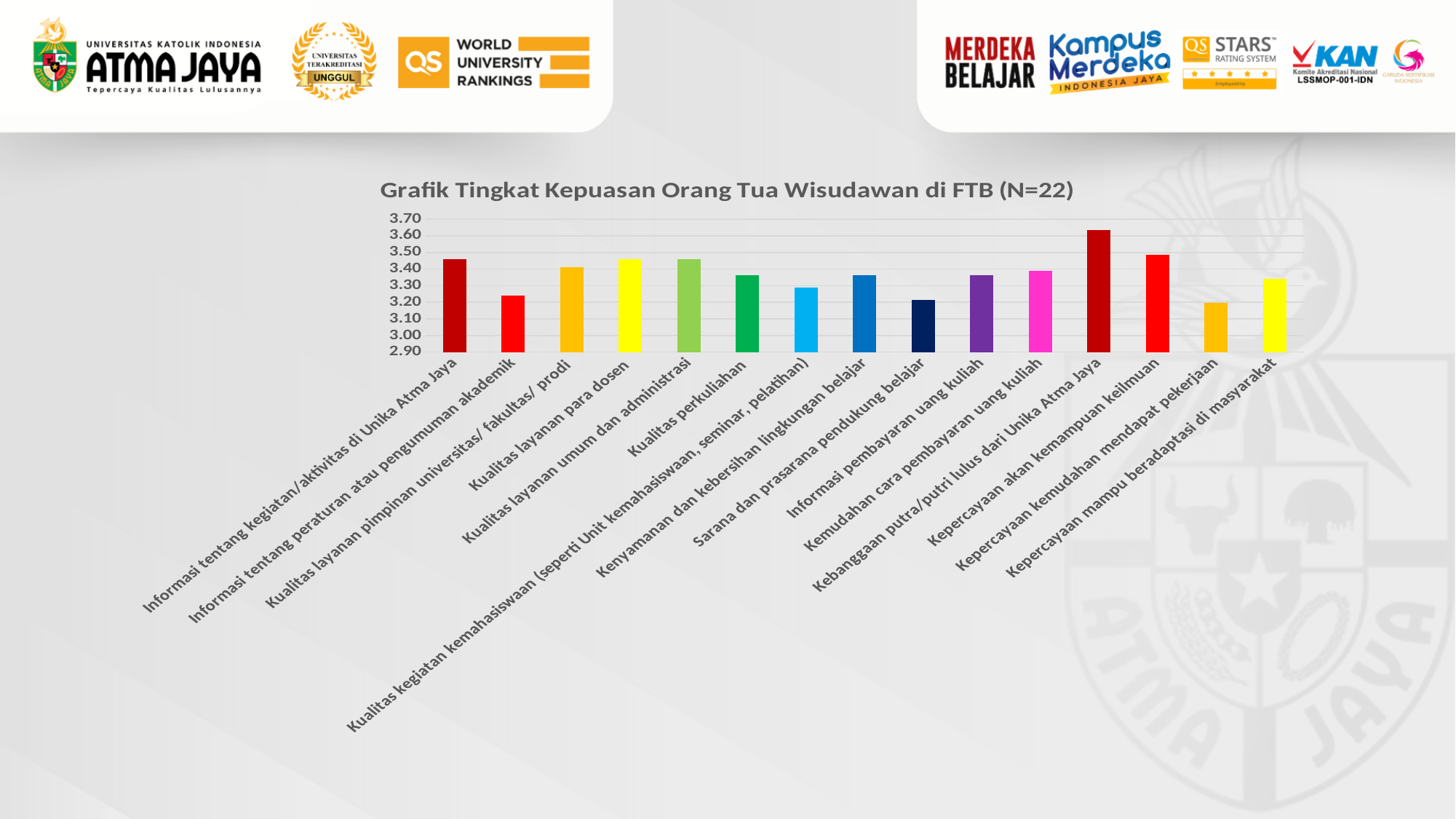
Is the value for Kualitas layanan para dosen greater or less than 3.40? greater Is the value for Kebanggaan putra/putri lulus dari Unika Atma Jaya greater or less than 3.50? greater Is the value for Sarana dan prasarana pendukung belajar greater or less than 3.30? less Which is larger: the value for Kebanggaan putra/putri lulus dari Unika Atma Jaya or the value for Informasi tentang peraturan atau pengumuman akademik? Kebanggaan putra/putri lulus dari Unika Atma Jaya Which category has the highest value in the chart? Kebanggaan putra/putri lulus dari Unika Atma Jaya Which is larger: the value for Kepercayaan akan kemampuan keilmuan or the value for Kepercayaan kemudahan mendapat pekerjaan? Kepercayaan akan kemampuan keilmuan What sample size (N) is stated in the chart title? 22 What kind of chart is shown on the slide? Bar chart What is the title of the chart? Grafik Tingkat Kepuasan Orang Tua Wisudawan di FTB (N=22) How many categories are plotted in the chart? 15